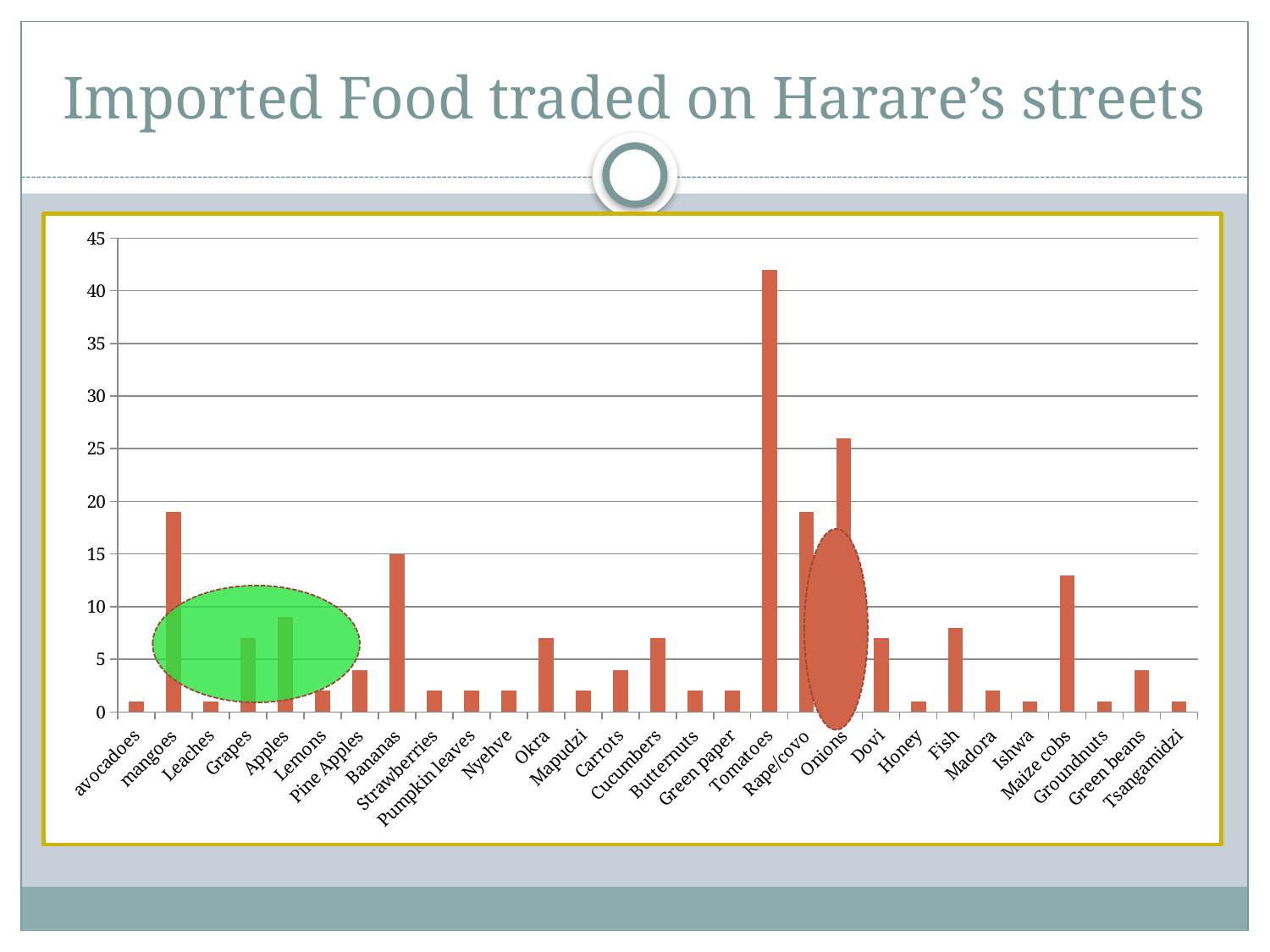
Which is larger, the value for Tomatoes or the value for Rape/covo? Tomatoes Which category has the highest bar? Tomatoes Is the value for Onions greater or less than 25? greater Which is larger, the value for Onions or the value for mangoes? Onions What kind of chart is shown on the slide? bar chart Is the value for Tomatoes greater or less than 40? greater Is the value for mangoes greater or less than 20? less What is the title of the slide? Imported Food traded on Harare's streets How many categories are shown on the x axis? 29